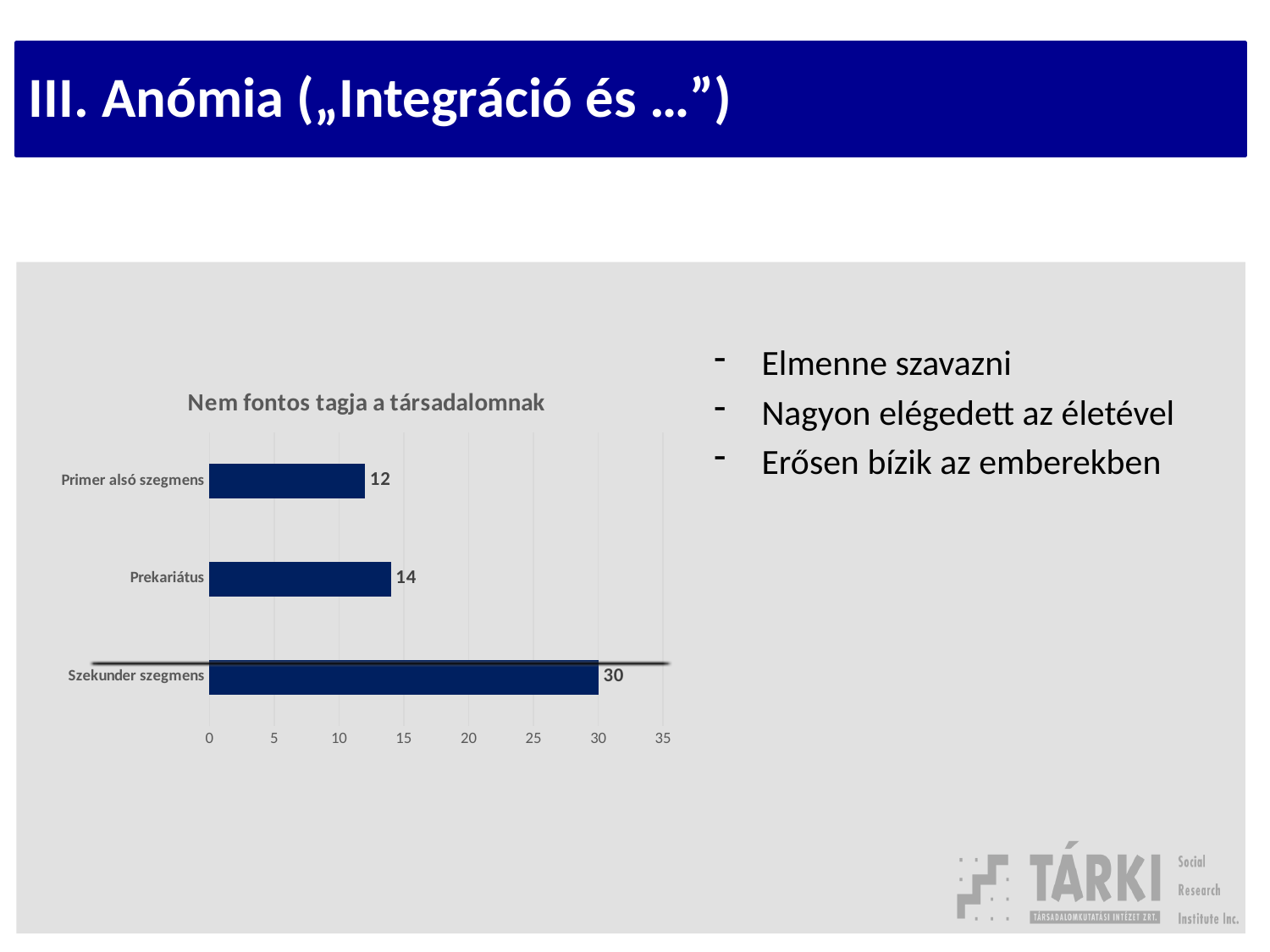
What is the title of the chart? Nem fontos tagja a társadalomnak Which is larger, the value for Prekariátus or the value for Primer alsó szegmens? Prekariátus What is the value for Prekariátus? 14 What is the value for Szekunder szegmens? 30 What is the difference between the values for Szekunder szegmens and Prekariátus? 16 Which category has the lowest value? Primer alsó szegmens What is the value for Primer alsó szegmens? 12 Which category has the highest value? Szekunder szegmens What kind of chart is shown on the slide? bar chart Is the value for Szekunder szegmens greater or less than 25? greater How many categories are shown in the chart? 3 What is the difference between the values for Prekariátus and Primer alsó szegmens? 2